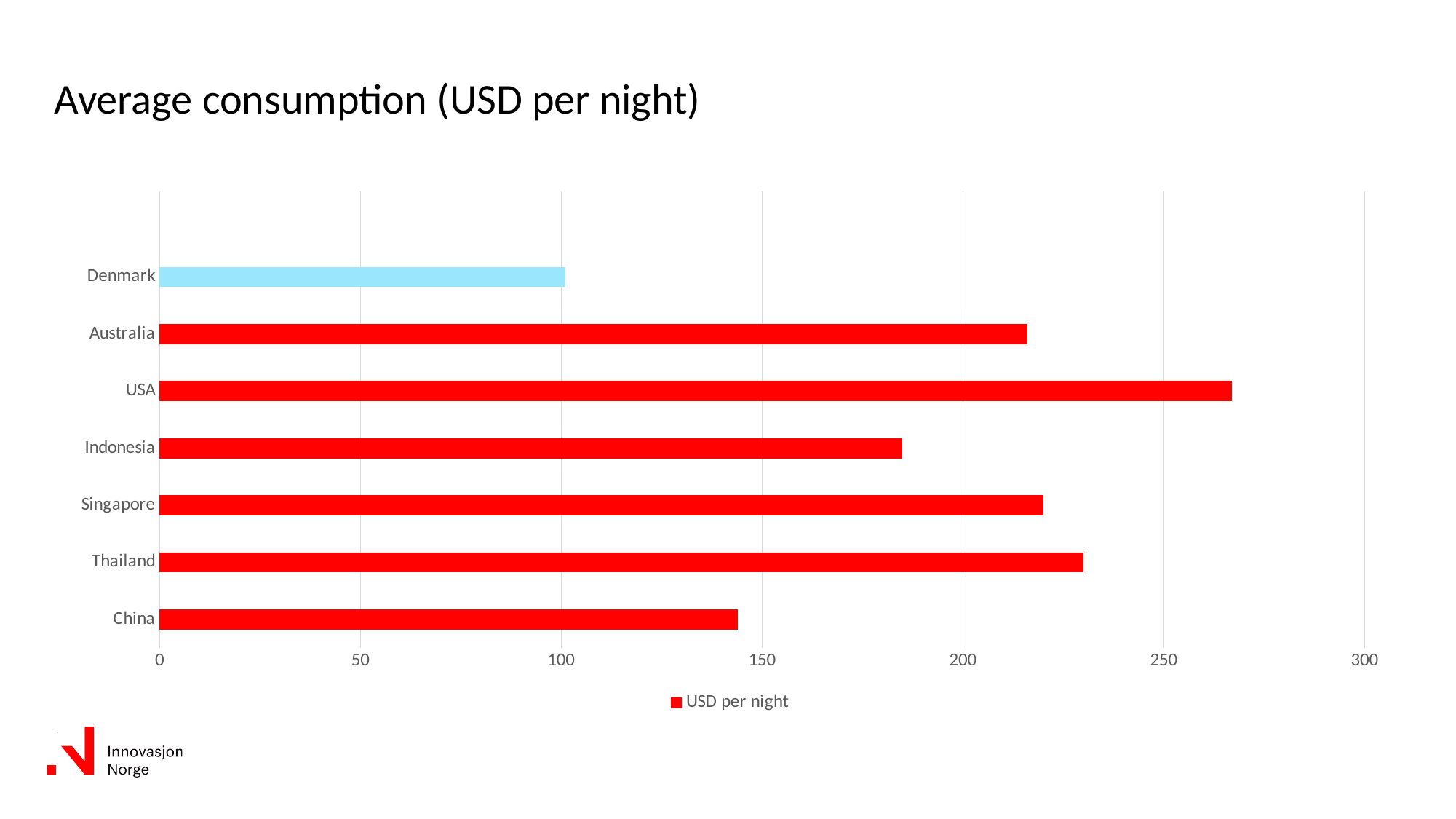
Is the value for Denmark greater or less than 150? less Which country has the highest average consumption per night? USA Which has a higher average consumption per night, USA or China? USA How many series does the legend list? 1 Which has a higher average consumption per night, Thailand or Indonesia? Thailand Which country has the lowest average consumption per night? Denmark What is the title of the chart? Average consumption (USD per night) Is the value for Thailand greater or less than 200? greater Is the value for USA greater or less than 250? greater How many countries are shown on the chart? 7 What kind of chart is shown on the slide? bar chart